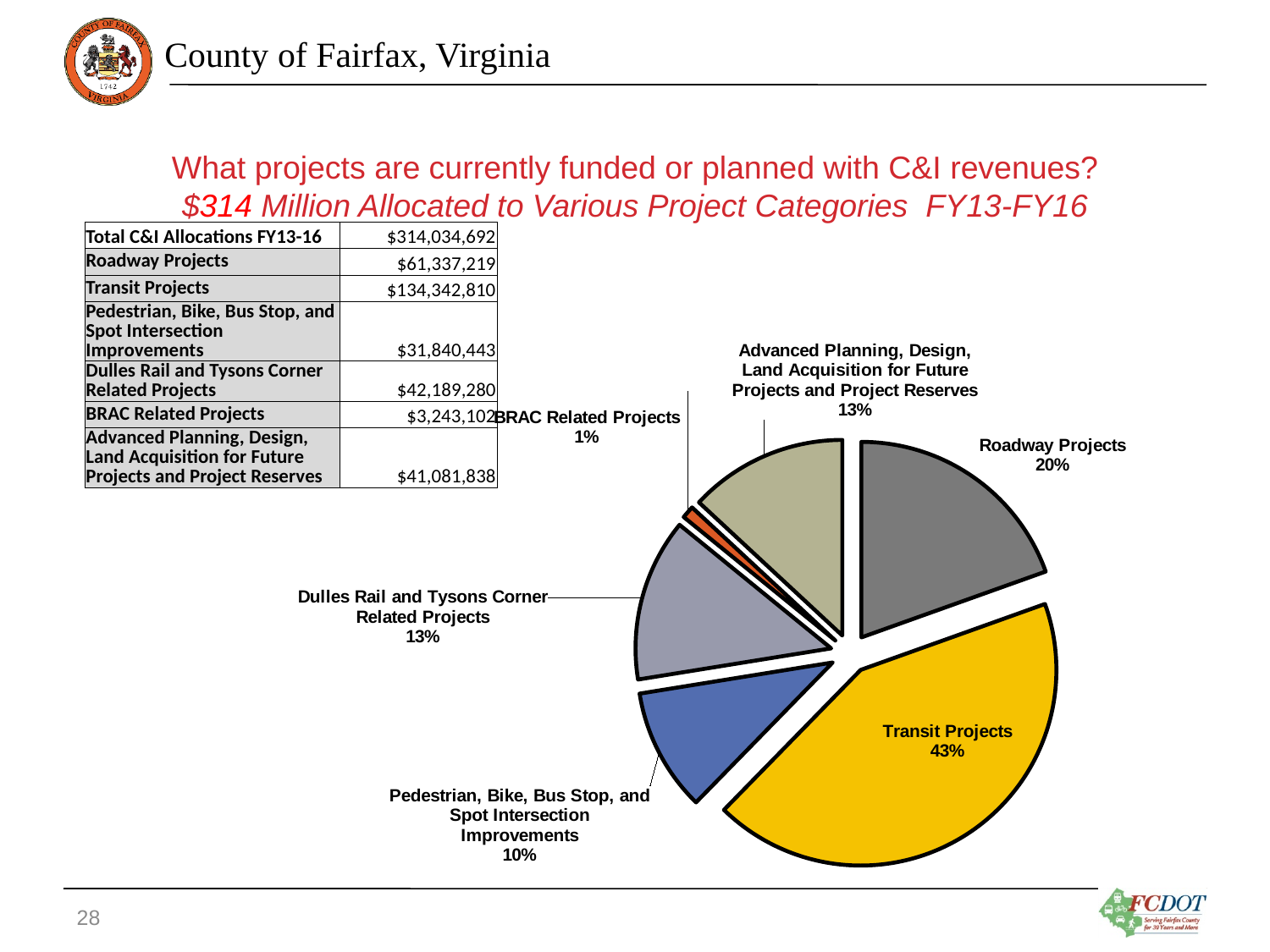
What percentage is shown for BRAC Related Projects? 1% What share of the pie does Roadway Projects represent? 20% What type of chart is shown on the slide? pie chart Which category has the largest slice of the pie? Transit Projects What colour is the Transit Projects slice? yellow Which category has the smallest slice of the pie? BRAC Related Projects Which is larger, the share for Roadway Projects or the share for Dulles Rail and Tysons Corner Related Projects? Roadway Projects What percentage is shown for Pedestrian, Bike, Bus Stop, and Spot Intersection Improvements? 10% How many slices does the pie chart have? 6 What share of the pie does Transit Projects represent? 43% What is the difference in percentage points between Transit Projects and Roadway Projects? 23 What percentage is shown for Dulles Rail and Tysons Corner Related Projects? 13%